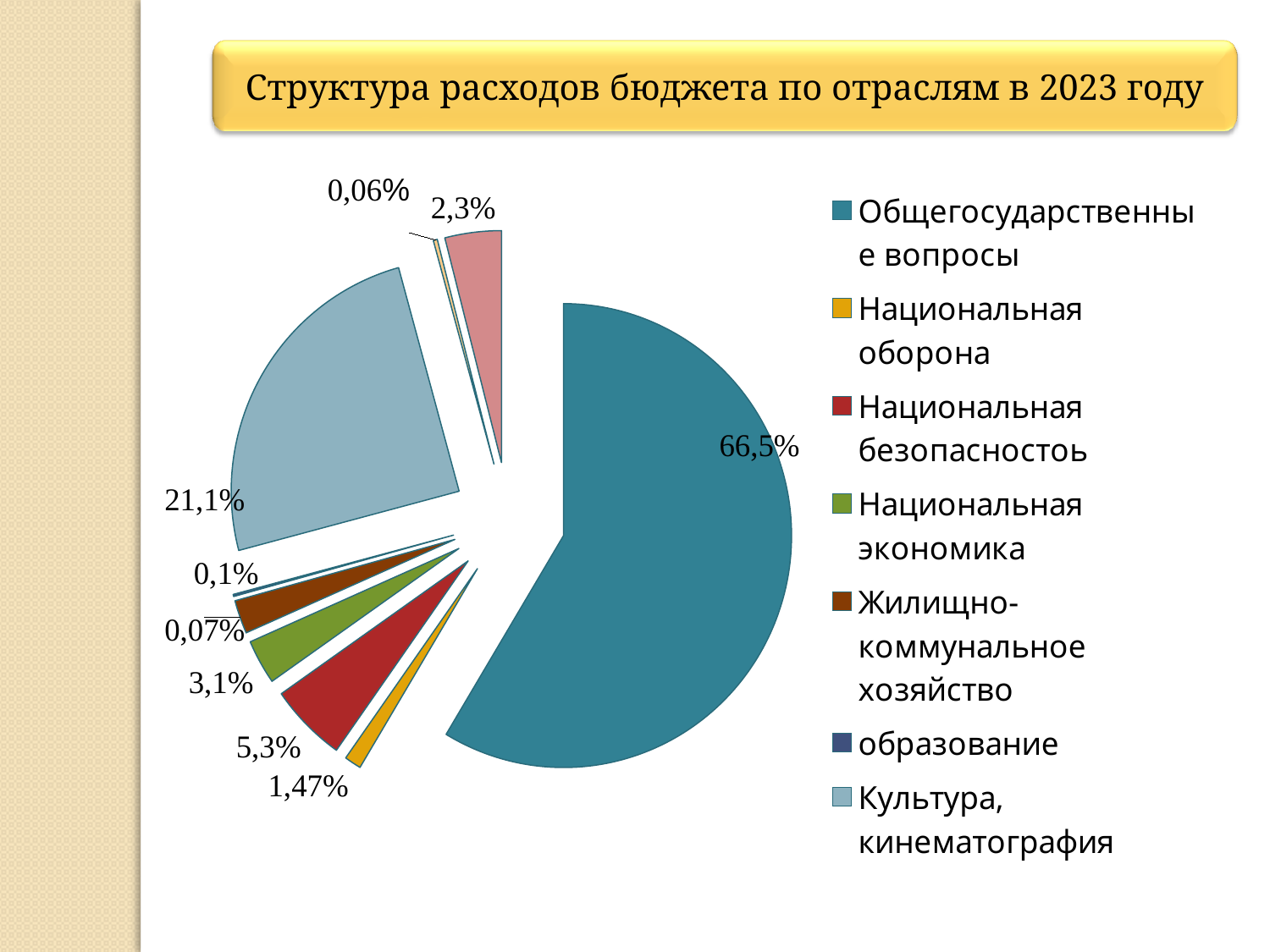
What kind of chart is shown on the slide? pie chart What share of budget expenditure goes to образование? 0,1% How many entries does the legend list? 7 What share of budget expenditure goes to Национальная оборона? 1,47% What share of budget expenditure goes to Культура, кинематография? 21,1% What share of budget expenditure goes to Общегосударственные вопросы? 66,5% What is the smallest percentage value labelled on the pie chart? 0,06% What share of budget expenditure goes to Национальная экономика? 3,1% Which has the larger share: Национальная безопасность or Национальная экономика? Национальная безопасность By how many percentage points does the share of Общегосударственные вопросы exceed the share of Культура, кинематография? 45,4% Which category has the largest share of the pie? Общегосударственные вопросы What share of budget expenditure goes to Национальная безопасность? 5,3%